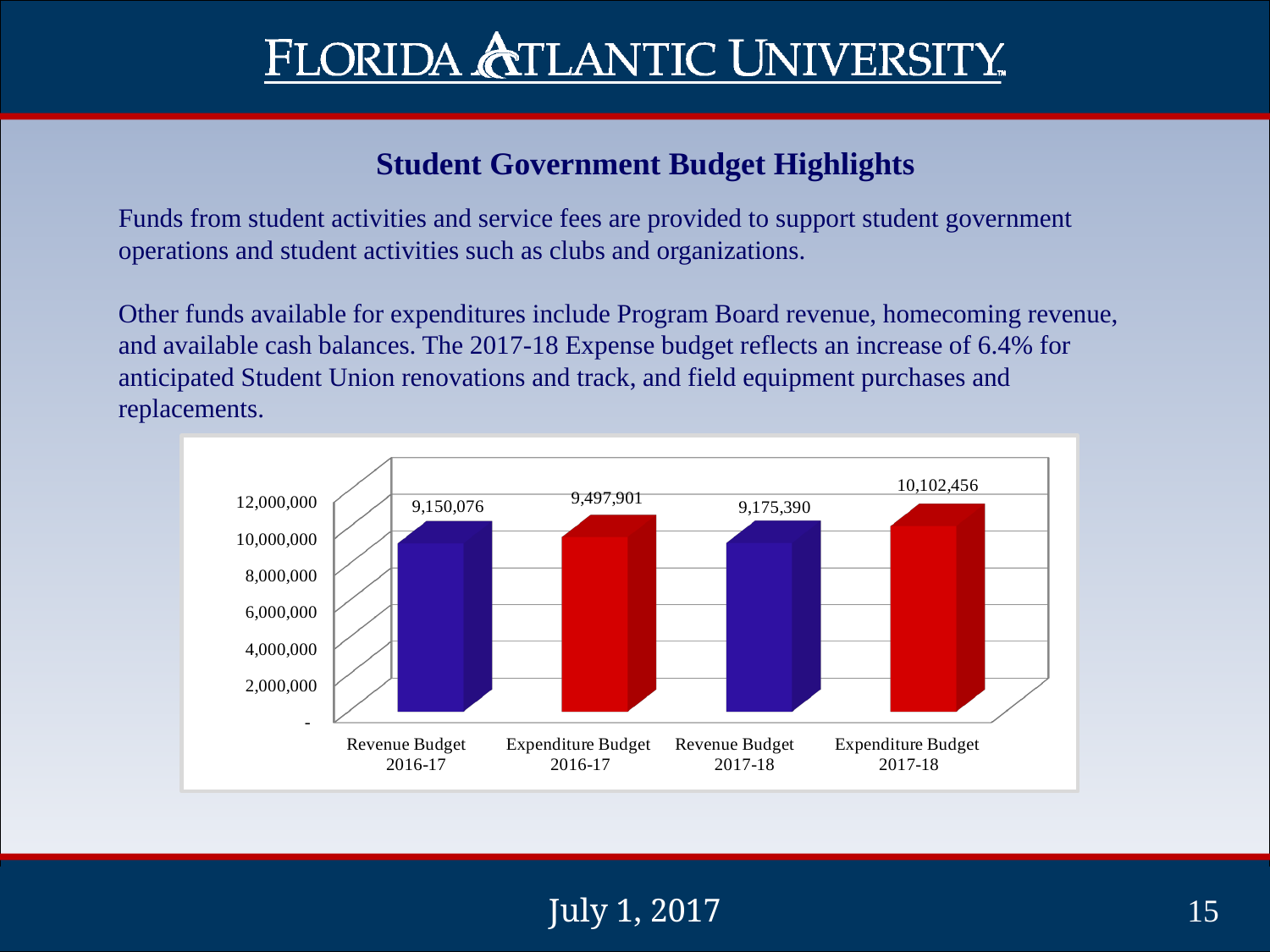
Is the value for Expenditure Budget 2017-18 greater or less than 10,000,000? greater Which category has the highest value in the chart? Expenditure Budget 2017-18 What is the value of the Expenditure Budget 2017-18 bar? 10,102,456 What is the value shown for Expenditure Budget 2016-17? 9,497,901 Which category has the lowest value in the chart? Revenue Budget 2016-17 How many bars are plotted in the chart? 4 What type of chart is shown on the slide? Bar chart What is the value of the Revenue Budget 2016-17 bar? 9,150,076 What is the difference between the Revenue Budget 2017-18 and the Revenue Budget 2016-17? 25,314 What is the value shown for Revenue Budget 2017-18? 9,175,390 Which is larger, the Expenditure Budget 2016-17 or the Revenue Budget 2016-17? Expenditure Budget 2016-17 What is the difference between the Expenditure Budget 2017-18 and the Expenditure Budget 2016-17? 604,555